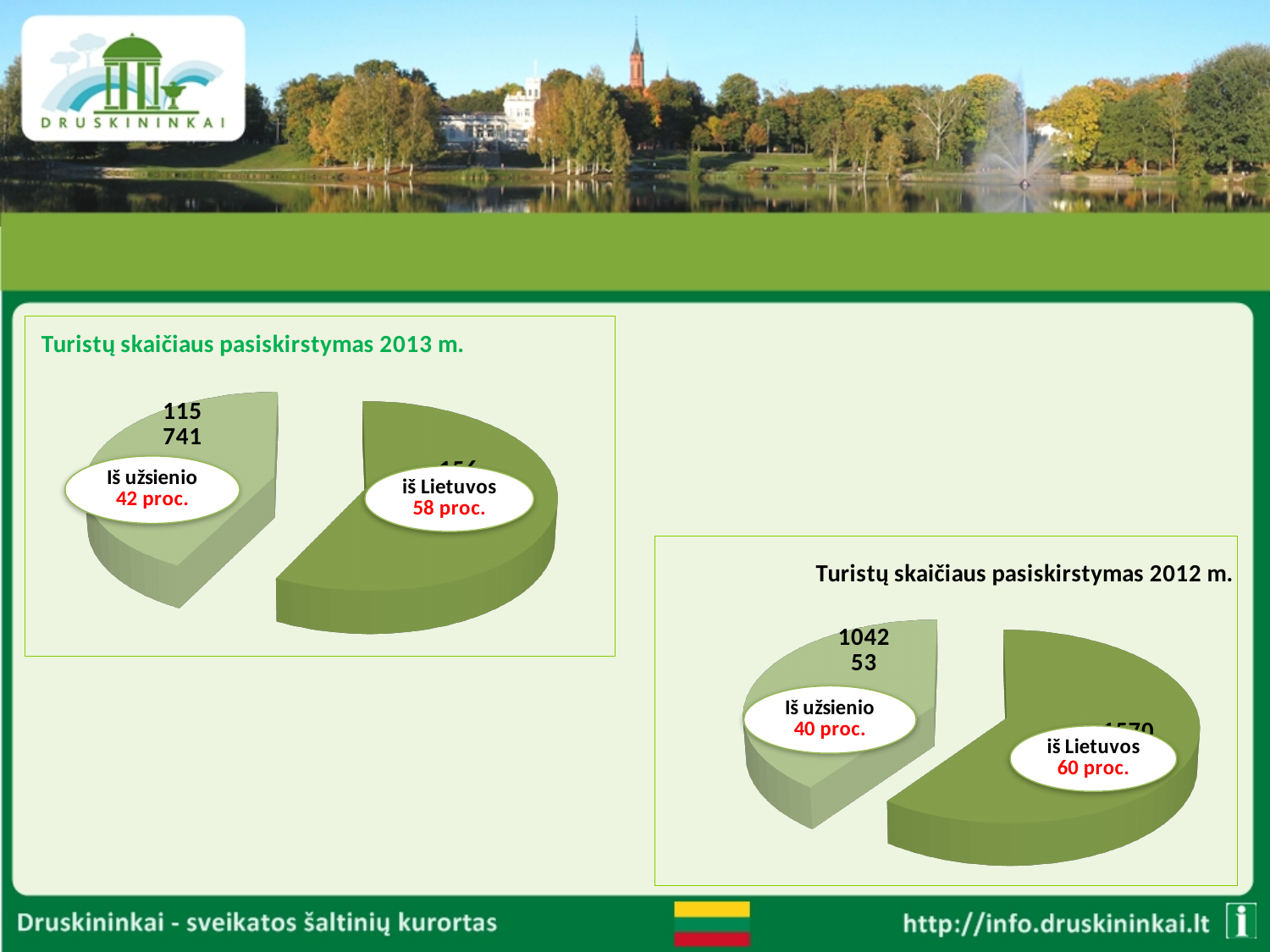
In the chart titled "Turistų skaičiaus pasiskirstymas 2013 m.", what number is printed on the "Iš užsienio" slice? 115 741 How many slices does the chart titled "Turistų skaičiaus pasiskirstymas 2012 m." have? 2 In the chart titled "Turistų skaičiaus pasiskirstymas 2013 m.", what share of tourists is labelled for "iš Lietuvos"? 58 proc. In the chart titled "Turistų skaičiaus pasiskirstymas 2012 m.", which slice is the smallest? Iš užsienio In the chart titled "Turistų skaičiaus pasiskirstymas 2013 m.", what share of tourists is labelled for "Iš užsienio"? 42 proc. How many charts are shown on the slide? 2 In the chart titled "Turistų skaičiaus pasiskirstymas 2013 m.", which slice is larger, "Iš užsienio" or "iš Lietuvos"? iš Lietuvos In the chart titled "Turistų skaičiaus pasiskirstymas 2012 m.", what share of tourists is labelled for "iš Lietuvos"? 60 proc. In the chart titled "Turistų skaičiaus pasiskirstymas 2012 m.", which slice is the largest? iš Lietuvos What kind of chart is the chart titled "Turistų skaičiaus pasiskirstymas 2013 m."? Pie chart In the chart titled "Turistų skaičiaus pasiskirstymas 2012 m.", what number is printed on the "Iš užsienio" slice? 1042 53